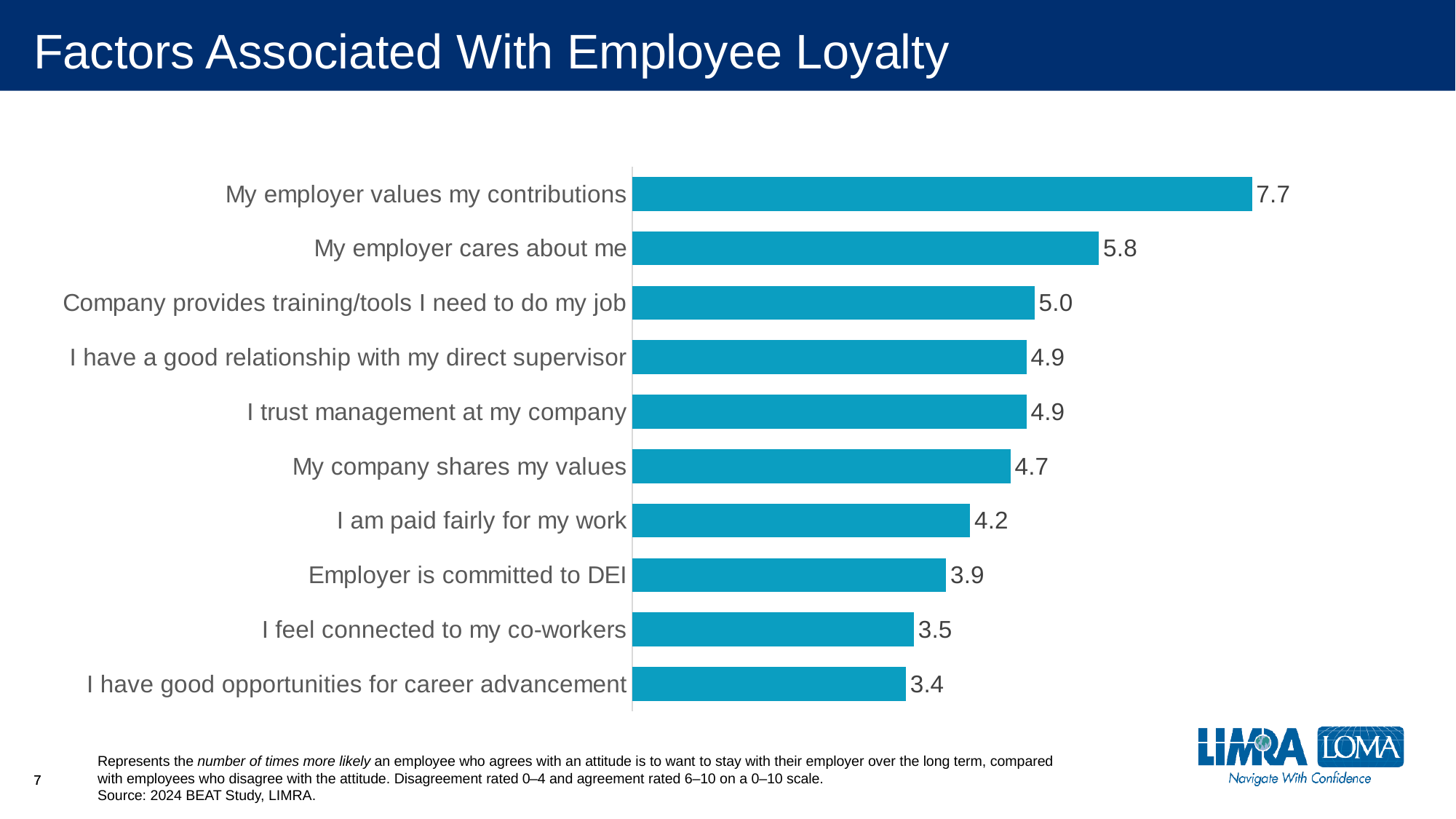
What is the difference between the values for "I feel connected to my co-workers" and "I have good opportunities for career advancement"? 0.1 What is the title of the slide? Factors Associated With Employee Loyalty What is the value for "Employer is committed to DEI"? 3.9 How many factors are shown in the chart? 10 What is the value for "My employer values my contributions"? 7.7 What is the value for "Company provides training/tools I need to do my job"? 5.0 Which is larger: the value for "My company shares my values" or the value for "I am paid fairly for my work"? My company shares my values Which factor has the lowest value? I have good opportunities for career advancement What is the value for "I am paid fairly for my work"? 4.2 What kind of chart is shown on the slide? Bar chart What is the difference between the values for "My employer values my contributions" and "My employer cares about me"? 1.9 Which factor has the highest value? My employer values my contributions